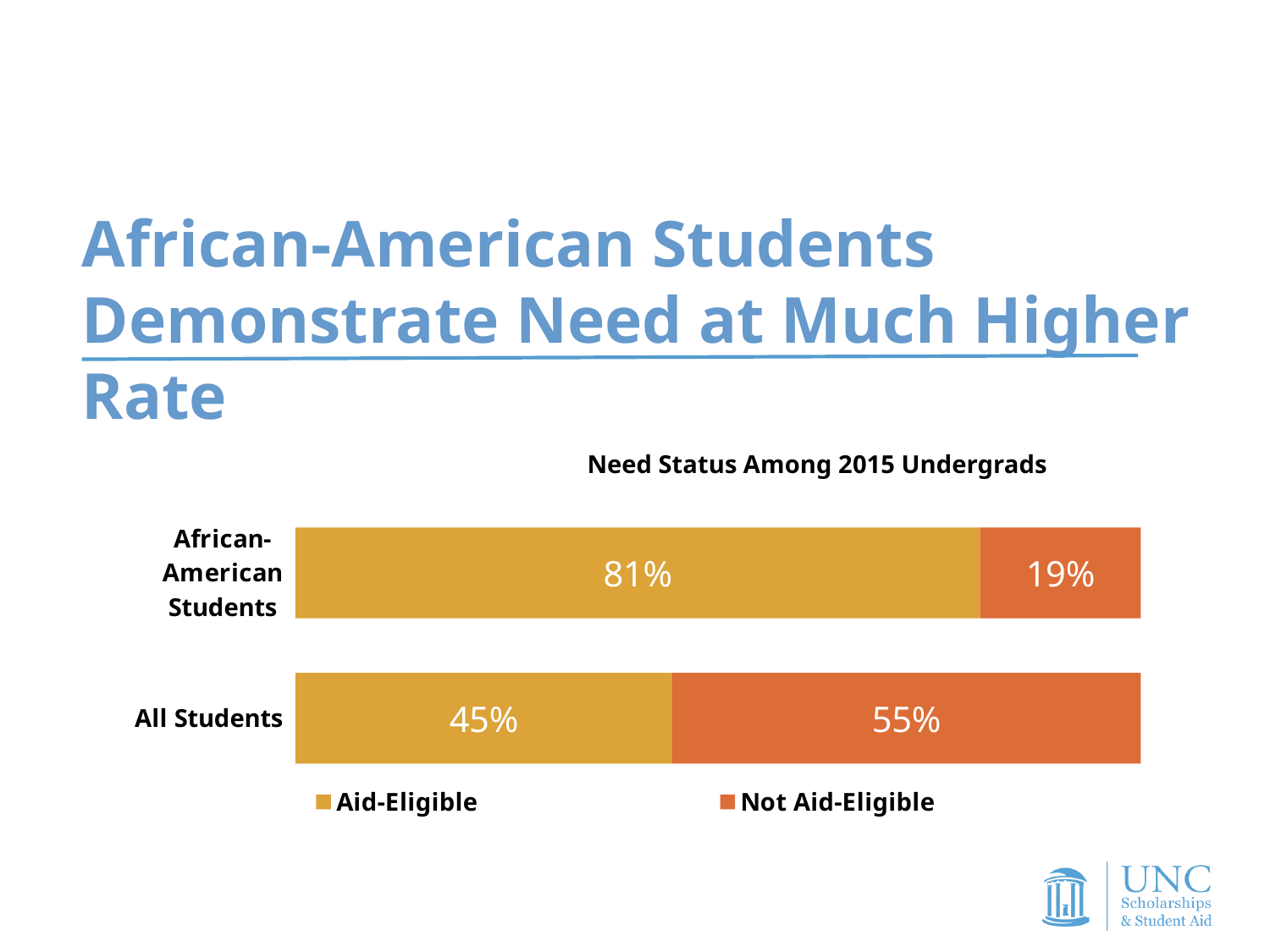
What is the title of the chart? Need Status Among 2015 Undergrads What kind of chart is shown on the slide? Stacked bar chart For All Students, which is larger: the Aid-Eligible share or the Not Aid-Eligible share? Not Aid-Eligible What percentage of African-American Students are Not Aid-Eligible? 19% What percentage of African-American Students are Aid-Eligible? 81% How many series does the legend list? 2 What is the difference in Aid-Eligible share between African-American Students and All Students? 36 percentage points What percentage of All Students are Not Aid-Eligible? 55% Which category has the higher Aid-Eligible share? African-American Students Which category has the lower Not Aid-Eligible share? African-American Students How many categories are shown on the chart? 2 What percentage of All Students are Aid-Eligible? 45%